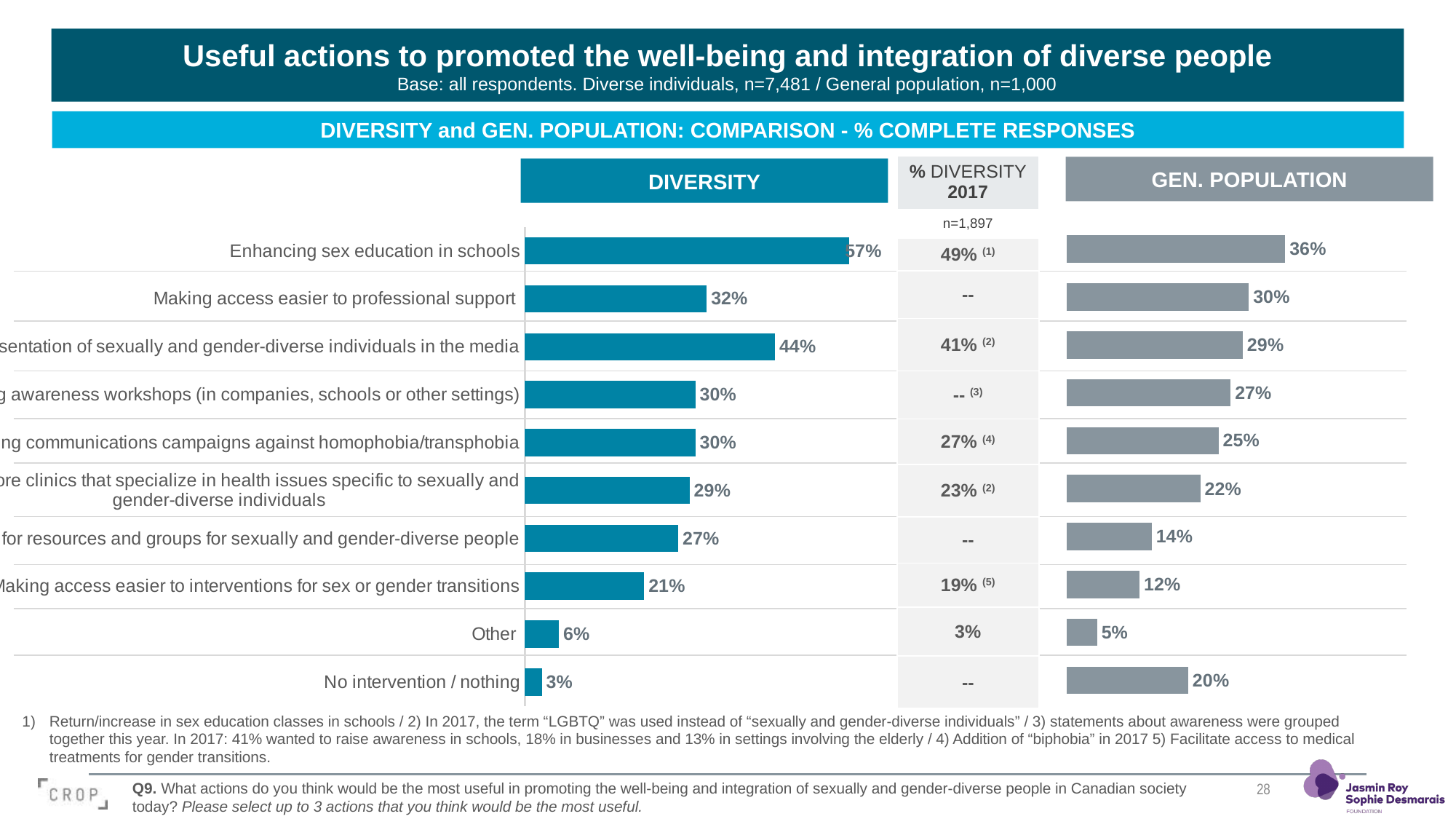
In the GEN. POPULATION chart, what is the value for Other? 5% In the DIVERSITY chart, which category has the lowest value? No intervention / nothing In the DIVERSITY chart, what is the value for Other? 6% How many categories are plotted in the DIVERSITY chart? 10 In the GEN. POPULATION chart, what is the value for No intervention / nothing? 20% In the GEN. POPULATION chart, what is the value for Making access easier to professional support? 30% In the DIVERSITY chart, what is the value for Making access easier to professional support? 32% For Making access easier to professional support, which chart shows the larger value, DIVERSITY or GEN. POPULATION? DIVERSITY In the DIVERSITY chart, which category has the highest value? Enhancing sex education in schools In the DIVERSITY chart, what is the value for No intervention / nothing? 3% In the GEN. POPULATION chart, which category has the lowest value? Other In the GEN. POPULATION chart, what is the difference between No intervention / nothing and Other? 15 percentage points